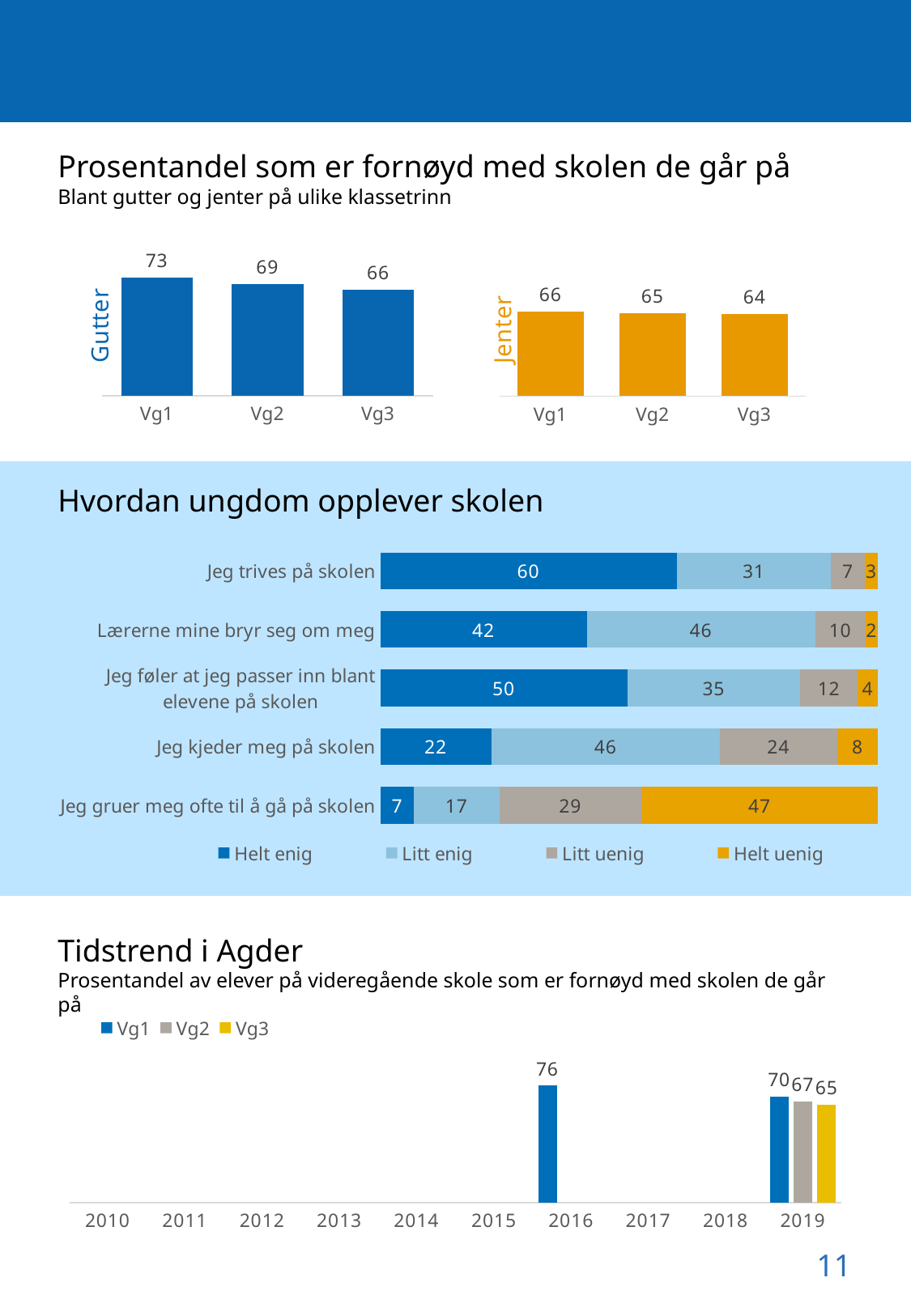
In the 'Prosentandel som er fornøyd med skolen de går på' chart, what is the difference between Gutter and Jenter in Vg2? 4 In the 'Hvordan ungdom opplever skolen' chart, what is the total of the bar for 'Jeg kjeder meg på skolen'? 100 In the 'Prosentandel som er fornøyd med skolen de går på' chart, what is the value for Gutter in Vg1? 73 In the 'Hvordan ungdom opplever skolen' chart, what is the 'Helt uenig' value for 'Jeg gruer meg ofte til å gå på skolen'? 47 In the 'Prosentandel som er fornøyd med skolen de går på' chart, which class level has the highest value for Gutter? Vg1 In the 'Tidstrend i Agder' chart, what is the Vg1 value for 2016? 76 In the 'Hvordan ungdom opplever skolen' chart, which statement has the lowest 'Helt enig' value? Jeg gruer meg ofte til å gå på skolen In the 'Hvordan ungdom opplever skolen' chart, how many series does the legend list? 4 In the 'Prosentandel som er fornøyd med skolen de går på' chart, do the Gutter values rise or fall from Vg1 to Vg3? fall In the 'Prosentandel som er fornøyd med skolen de går på' chart, what is the value for Jenter in Vg3? 64 In the 'Hvordan ungdom opplever skolen' chart, what is the 'Helt enig' value for 'Jeg trives på skolen'? 60 In the 'Tidstrend i Agder' chart, what is the difference between the Vg1 and Vg3 values in 2019? 5